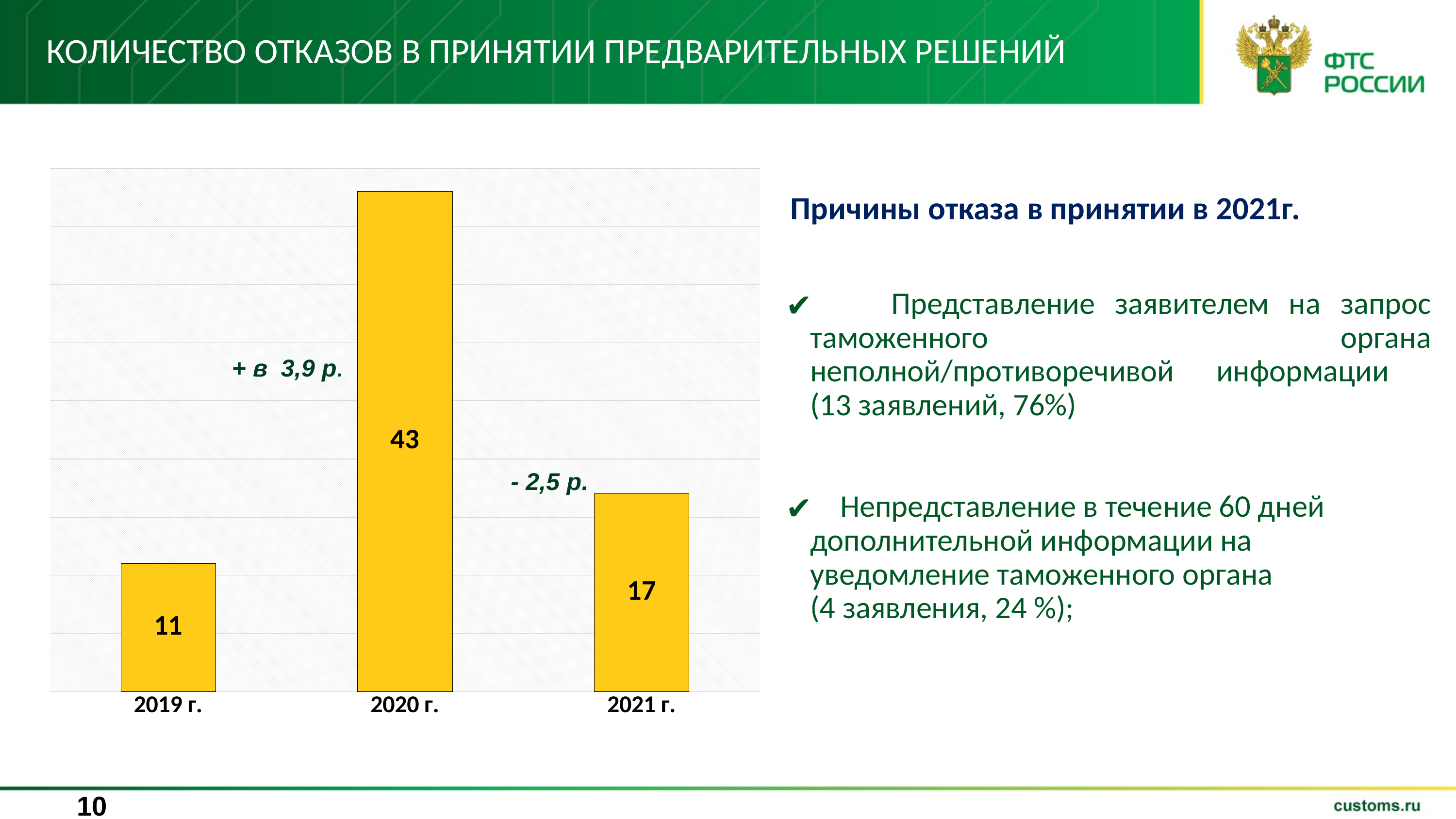
Which year has the lowest value? 2019 г. What kind of chart is shown on the slide? bar chart What is the value for 2019 г.? 11 What is the value for 2021 г.? 17 How many years are shown on the chart? 3 What annotation is shown between the 2019 г. and 2020 г. bars? + в 3,9 р. What annotation is shown between the 2020 г. and 2021 г. bars? - 2,5 р. What is the difference between the values for 2021 г. and 2019 г.? 6 Which year has the highest value? 2020 г. Which is larger, the value for 2019 г. or the value for 2021 г.? 2021 г. What is the value for 2020 г.? 43 What is the difference between the values for 2020 г. and 2021 г.? 26